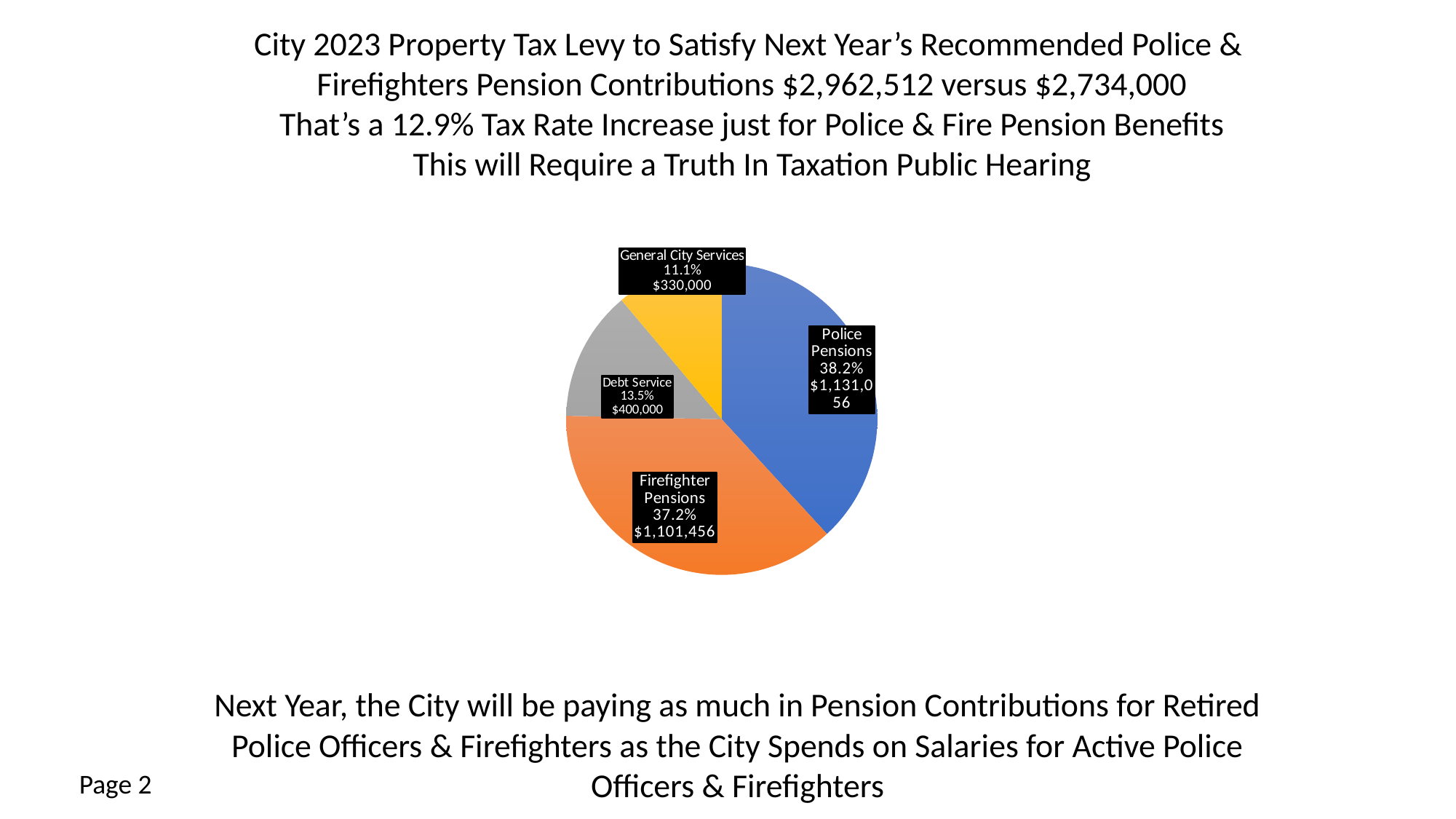
What share of the pie does Debt Service represent? 13.5% What dollar amount is shown for Debt Service? $400,000 Which slice of the pie chart is the smallest? General City Services What dollar amount is shown for Firefighter Pensions? $1,101,456 What is the difference in dollars between Debt Service and General City Services? $70,000 What dollar amount is shown for General City Services? $330,000 Which slice of the pie chart is the largest? Police Pensions What share of the pie does Police Pensions represent? 38.2% Which is larger, the Debt Service slice or the General City Services slice? Debt Service What dollar amount is shown for Police Pensions? $1,131,056 What kind of chart is shown on the slide? pie chart How many slices does the pie chart have? 4